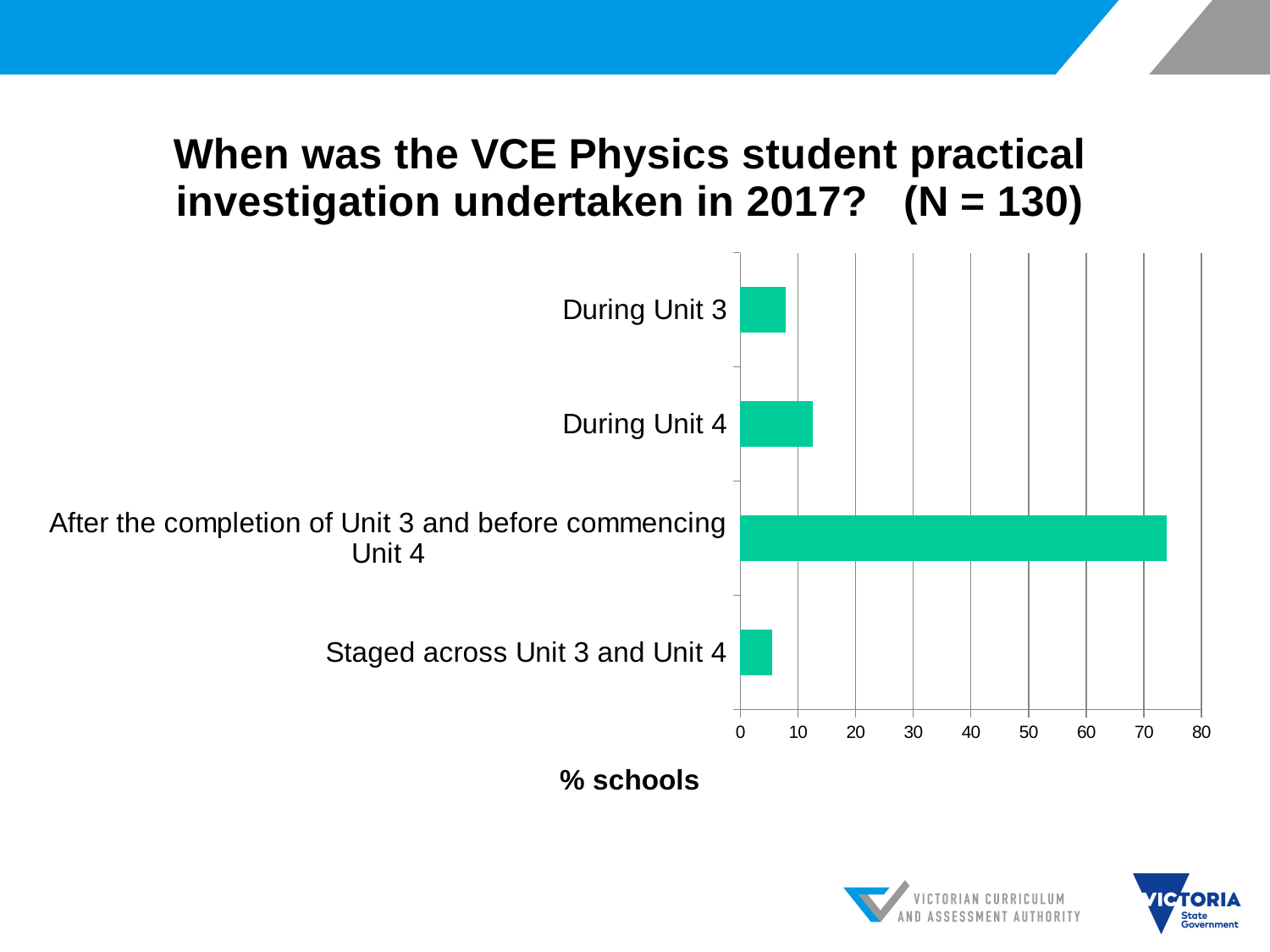
Is the value for 'After the completion of Unit 3 and before commencing Unit 4' greater or less than 70? greater What is the sample size (N) stated in the chart title? 130 What is the label on the horizontal axis of the chart? % schools How many categories are plotted in the chart? 4 Which is larger, the value for 'During Unit 4' or the value for 'After the completion of Unit 3 and before commencing Unit 4'? After the completion of Unit 3 and before commencing Unit 4 Is the value for 'During Unit 3' greater or less than 10? less Is the value for 'Staged across Unit 3 and Unit 4' greater or less than 10? less What kind of chart is shown on the slide? bar chart Which is larger, the value for 'During Unit 4' or the value for 'During Unit 3'? During Unit 4 Which category has the highest value? After the completion of Unit 3 and before commencing Unit 4